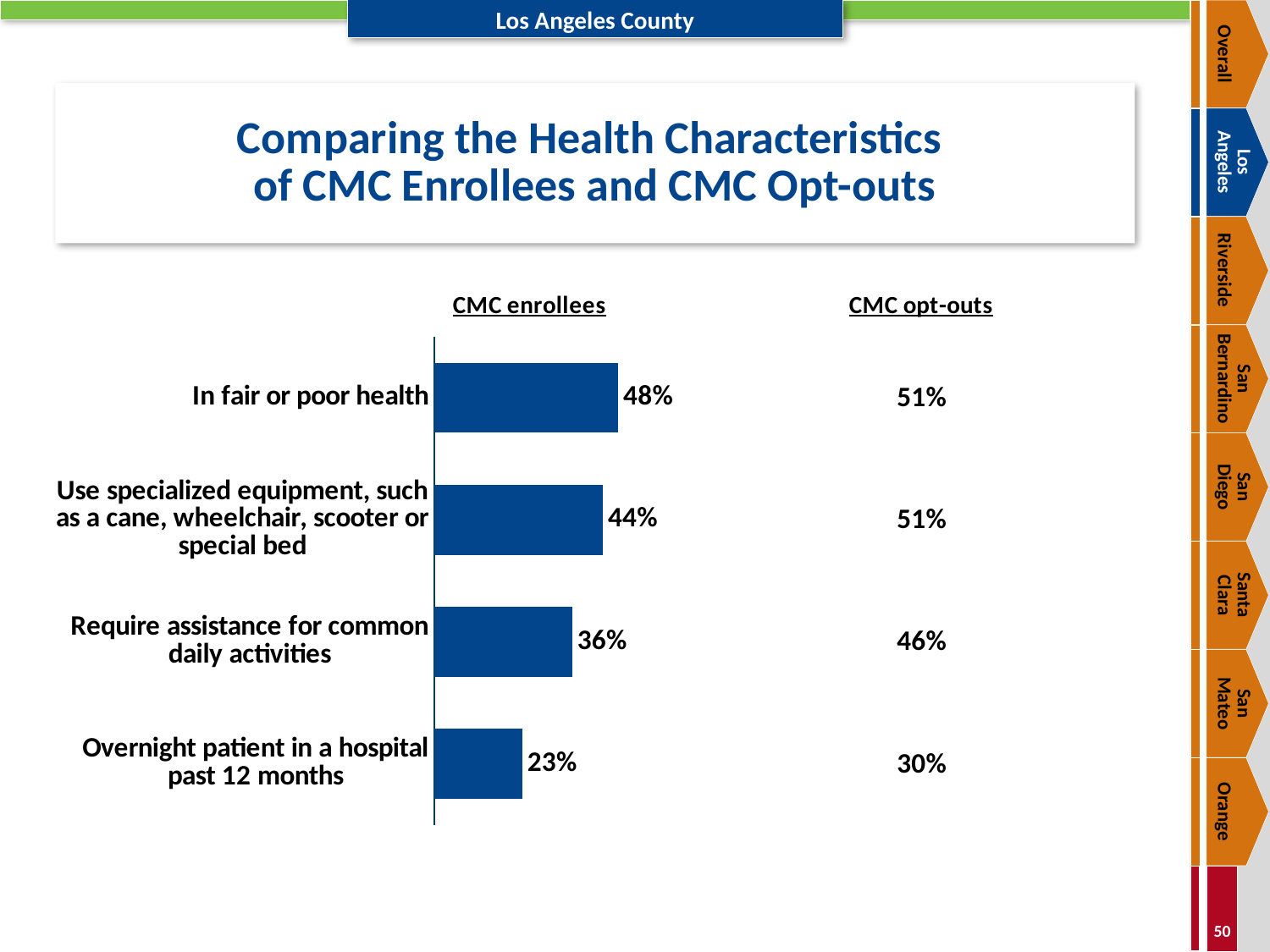
What type of chart is used to show the CMC enrollees values? Bar chart What percentage of CMC enrollees were an overnight patient in a hospital in the past 12 months? 23% What is the difference between CMC enrollees in fair or poor health and CMC enrollees who were an overnight patient in a hospital in the past 12 months? 25 percentage points What is the title of the slide's chart? Comparing the Health Characteristics of CMC Enrollees and CMC Opt-outs What percentage of CMC opt-outs require assistance for common daily activities? 46% For using specialized equipment, which group has the larger percentage, CMC enrollees or CMC opt-outs? CMC opt-outs How many health characteristics are shown in the chart? 4 Which health characteristic has the lowest percentage among CMC enrollees? Overnight patient in a hospital past 12 months What is the difference between CMC opt-outs and CMC enrollees for requiring assistance for common daily activities? 10 percentage points What percentage of CMC enrollees are in fair or poor health? 48% What percentage of CMC opt-outs use specialized equipment, such as a cane, wheelchair, scooter or special bed? 51% Which health characteristic has the highest percentage among CMC enrollees? In fair or poor health